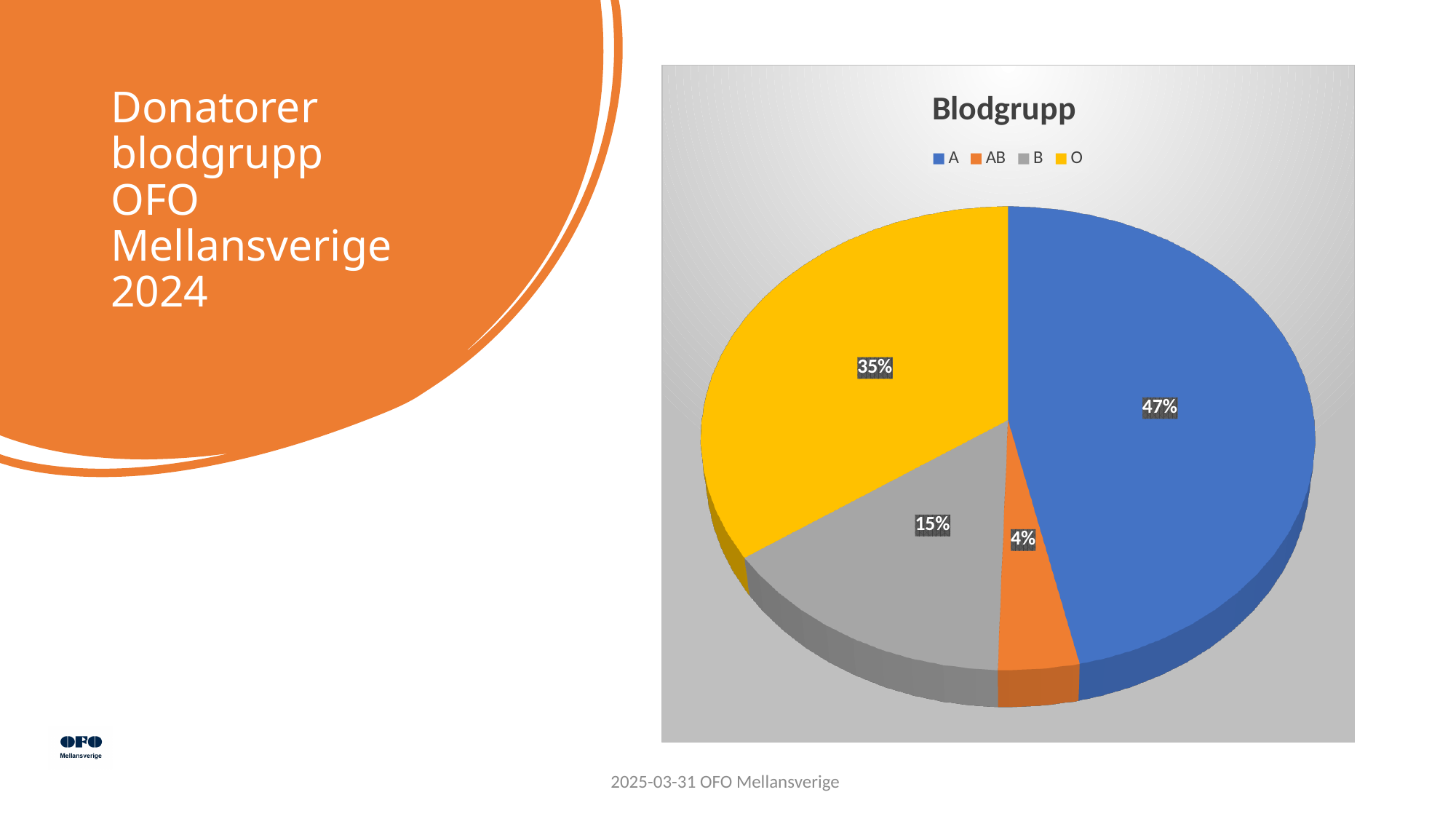
Which has a larger share, blood group B or blood group O? O What is the difference in percentage points between blood group A and blood group O? 12 What kind of chart is shown on the slide? Pie chart What is the difference in percentage points between blood group B and blood group AB? 11 What share of the pie does blood group B have? 15% Which blood group has the smallest share of the pie? AB What share of the pie does blood group AB have? 4% What share of the pie does blood group A have? 47% What share of the pie does blood group O have? 35% Which blood group has the largest share of the pie? A How many blood groups are shown in the pie chart? 4 What is the title of the chart? Blodgrupp